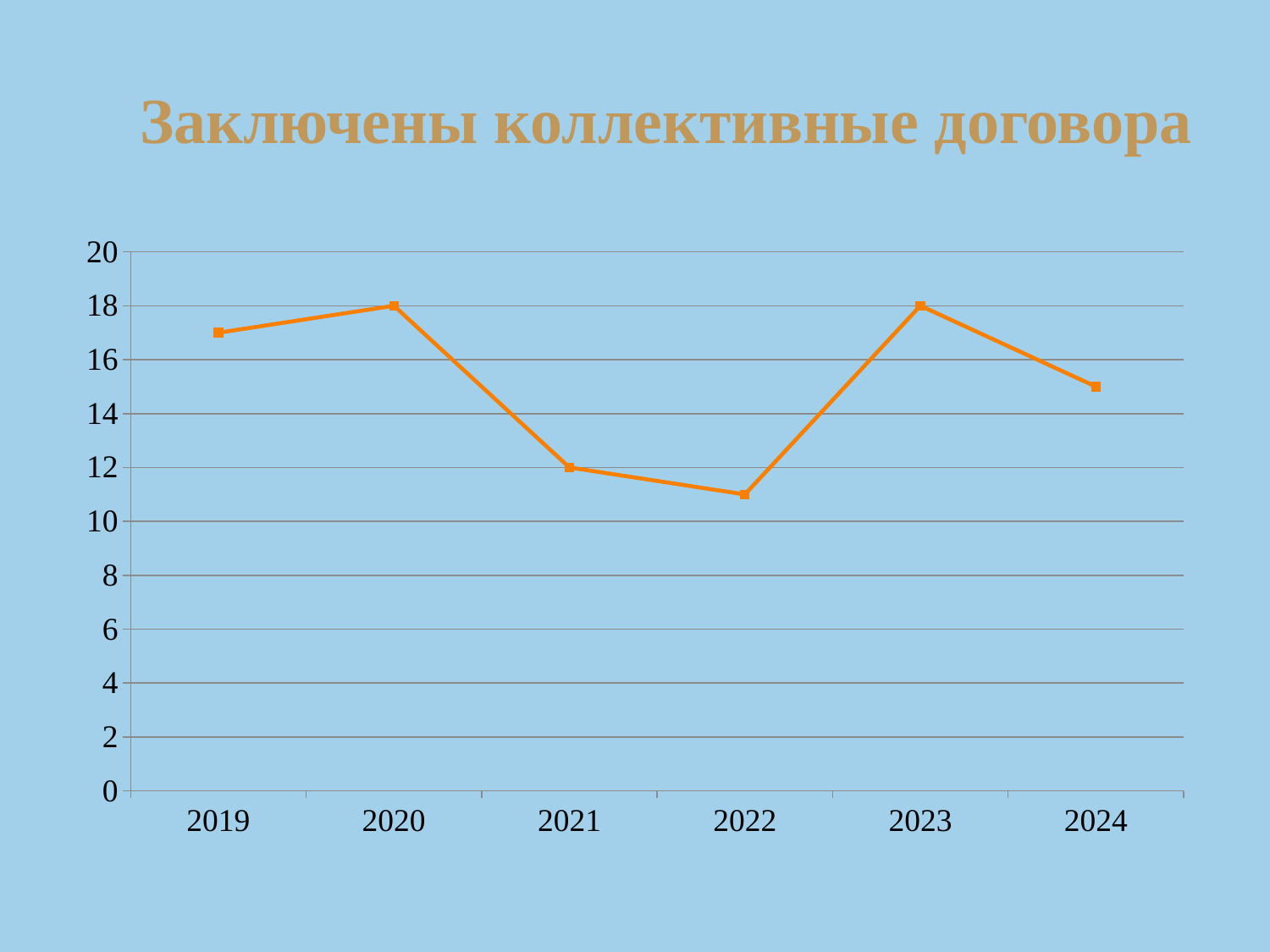
What is the value for 2021? 12 How many years are plotted on the x axis? 6 Do the values rise or fall from 2020 to 2022? fall What is the value for 2020? 18 Is the value for 2019 greater or less than 16? greater What is the difference between the values for 2020 and 2021? 6 Is the value for 2022 greater or less than 12? less What is the title of the chart? Заключены коллективные договора Is the value for 2024 greater or less than 16? less What is the value for 2023? 18 What kind of chart is shown on the slide? line chart Which year has the lowest value? 2022